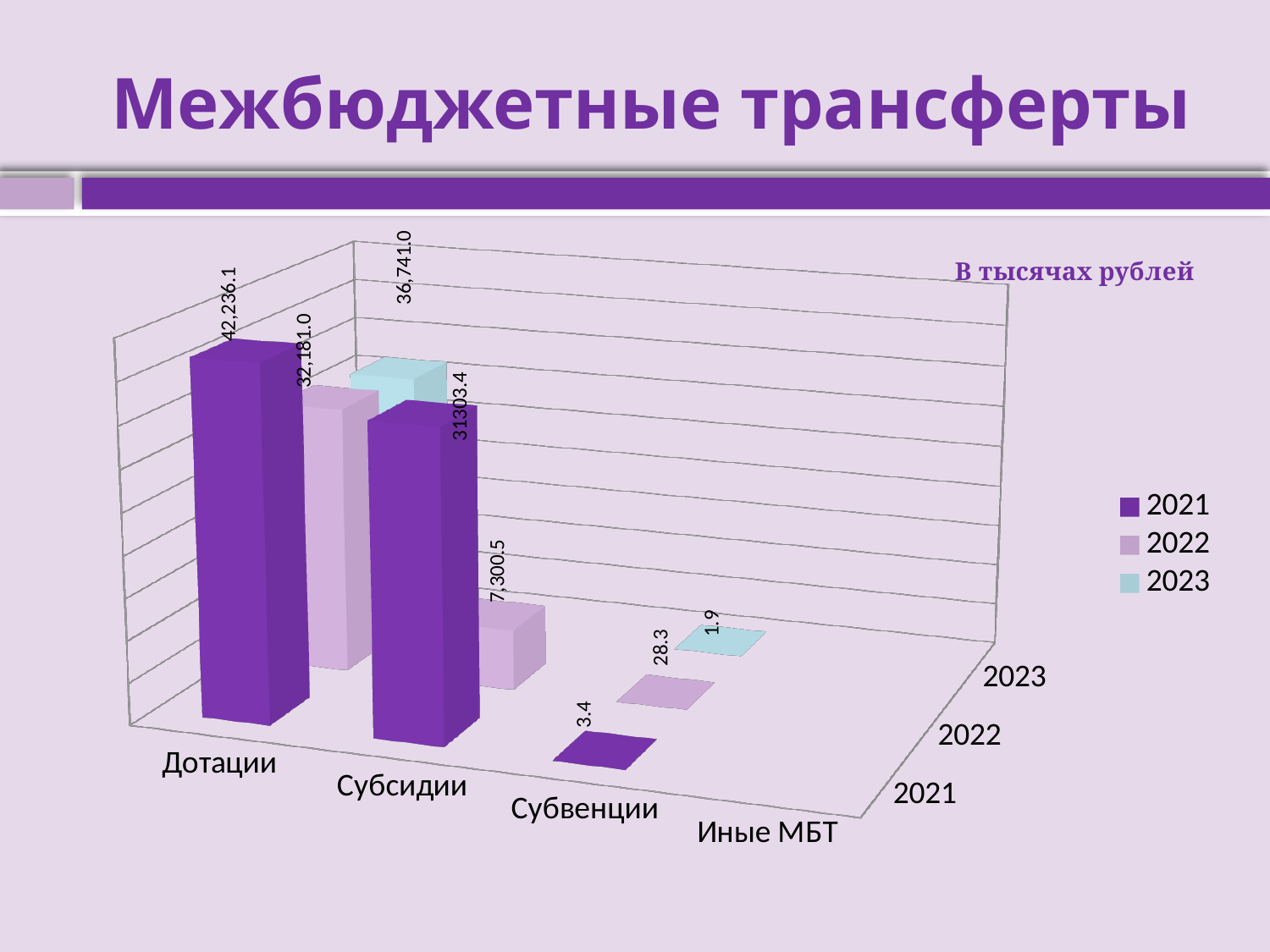
What is the value for Дотации in 2023? 31303.4 How many categories are shown on the category axis? 4 What is the value for Субсидии in 2022? 7,300.5 What is the value for Дотации in 2022? 32,181.0 What is the difference between the Дотации values for 2021 and 2022? 10,055.1 What is the value for Дотации in 2021? 42,236.1 Which year has the highest value for Дотации? 2021 What kind of chart is shown on the slide? bar chart What is the value for Субвенции in 2021? 3.4 For Субвенции, which is larger: the 2021 value or the 2022 value? 2022 What is the value for Субвенции in 2023? 1.9 How many series does the legend list? 3